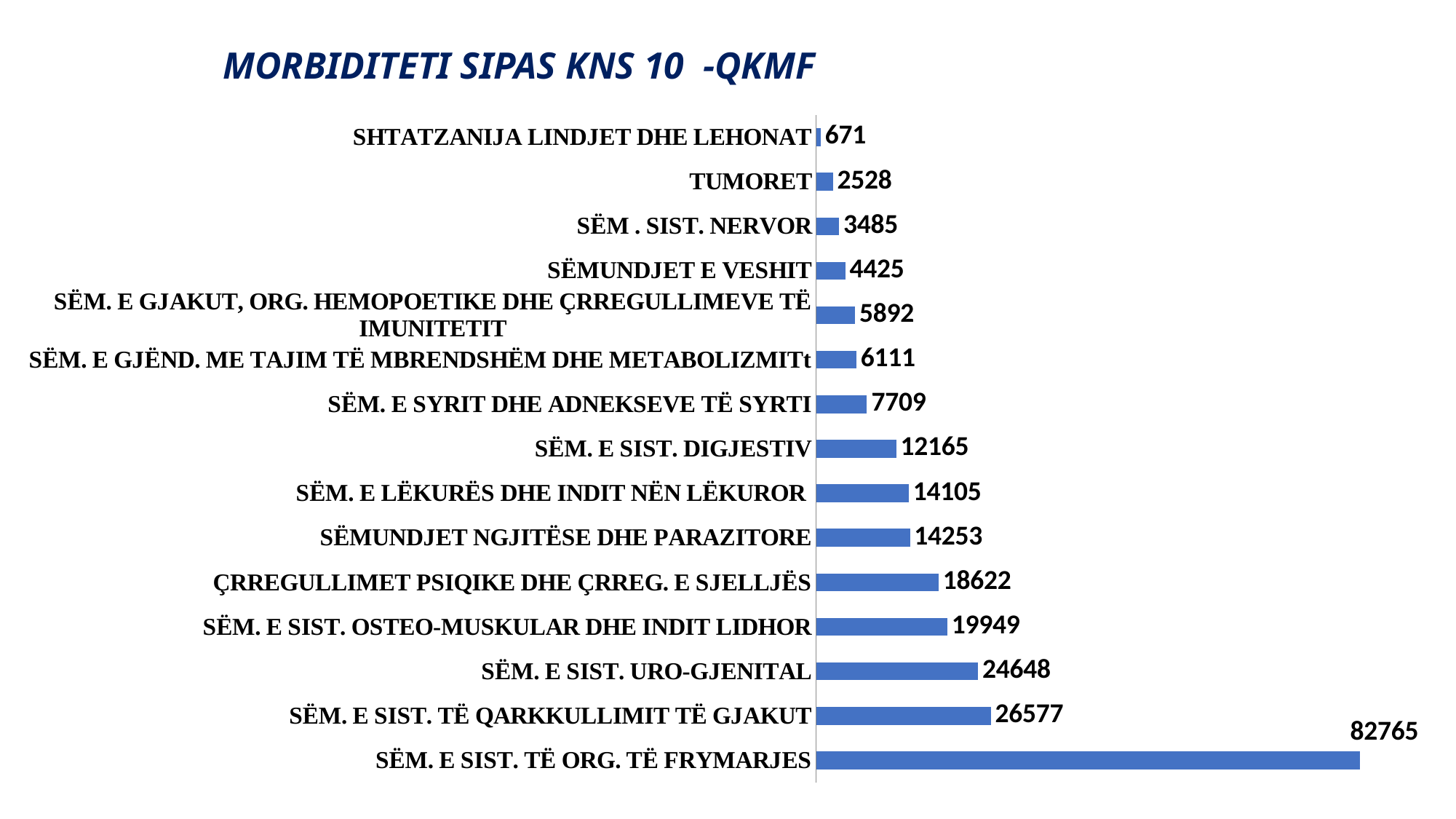
Which category has the lowest value? SHTATZANIJA LINDJET DHE LEHONAT What is the value for SËM. E SIST. DIGJESTIV? 12165 What is the title of the chart? MORBIDITETI SIPAS KNS 10 -QKMF What is the difference between the values for SËMUNDJET NGJITËSE DHE PARAZITORE and SËM. E LËKURËS DHE INDIT NËN LËKUROR? 148 Which category has the highest value? SËM. E SIST. TË ORG. TË FRYMARJES What kind of chart is shown on the slide? Bar chart How many categories are shown in the chart? 15 Which is larger, the value for SËM. E SIST. URO-GJENITAL or the value for SËM. E SIST. OSTEO-MUSKULAR DHE INDIT LIDHOR? SËM. E SIST. URO-GJENITAL What is the value for TUMORET? 2528 What is the value for SËM. E GJËND. ME TAJIM TË MBRENDSHËM DHE METABOLIZMITt? 6111 What is the value for SËM. E SIST. TË ORG. TË FRYMARJES? 82765 What is the difference between the values for SËM. E SIST. TË ORG. TË FRYMARJES and SËM. E SIST. TË QARKKULLIMIT TË GJAKUT? 56188